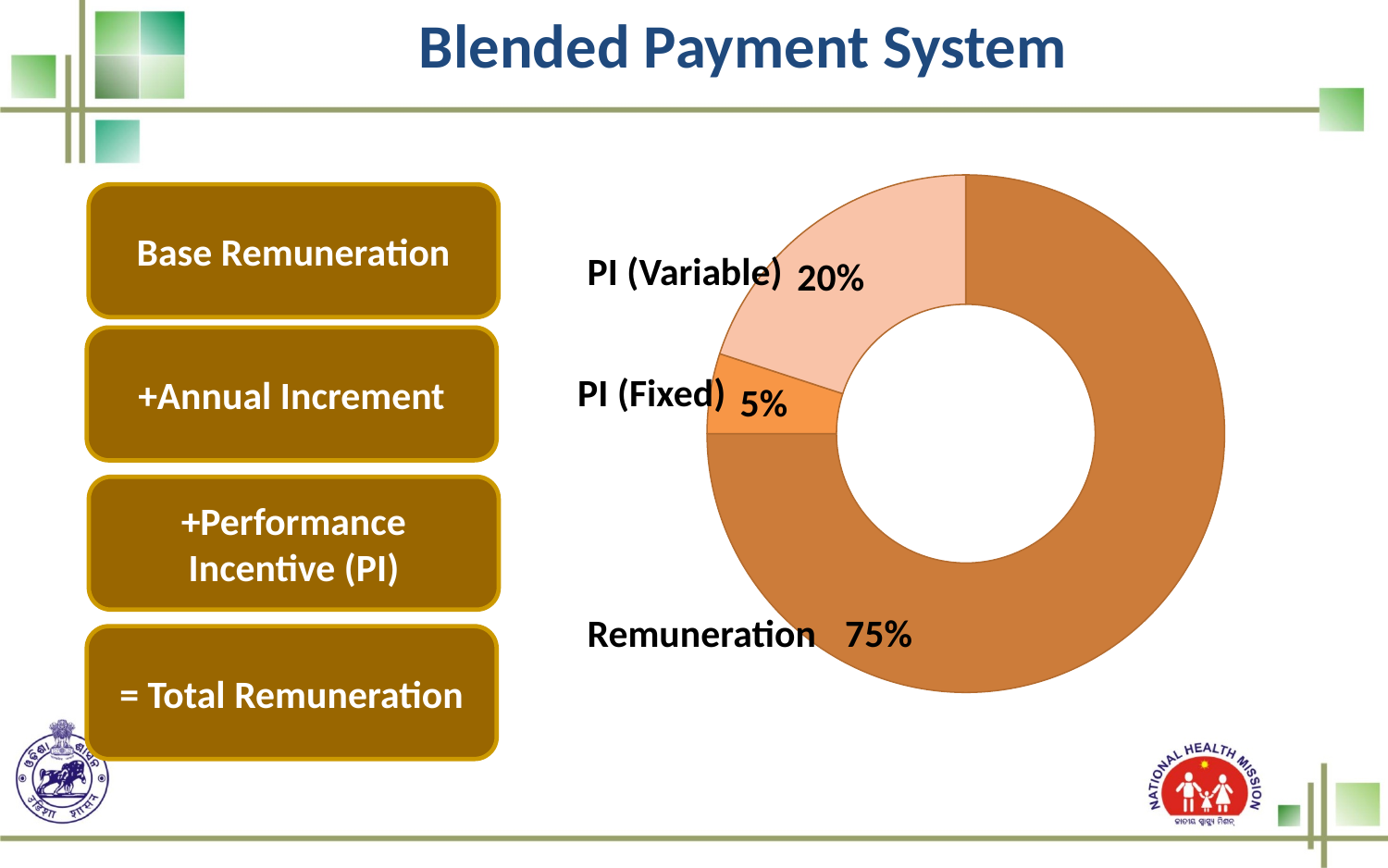
How many categories are shown in the doughnut chart? 3 What kind of chart is shown on the slide? Doughnut chart What share of the doughnut chart is Remuneration? 75% What is the title of the slide containing the chart? Blended Payment System Which category has the largest slice in the doughnut chart? Remuneration What is the combined share of PI (Fixed) and PI (Variable)? 25% What is the difference between the Remuneration share and the PI (Variable) share? 55% What share of the doughnut chart is PI (Variable)? 20% What share of the doughnut chart is PI (Fixed)? 5% What is the difference between the PI (Variable) share and the PI (Fixed) share? 15% Which category has the smallest slice in the doughnut chart? PI (Fixed) Which is larger, PI (Variable) or PI (Fixed)? PI (Variable)